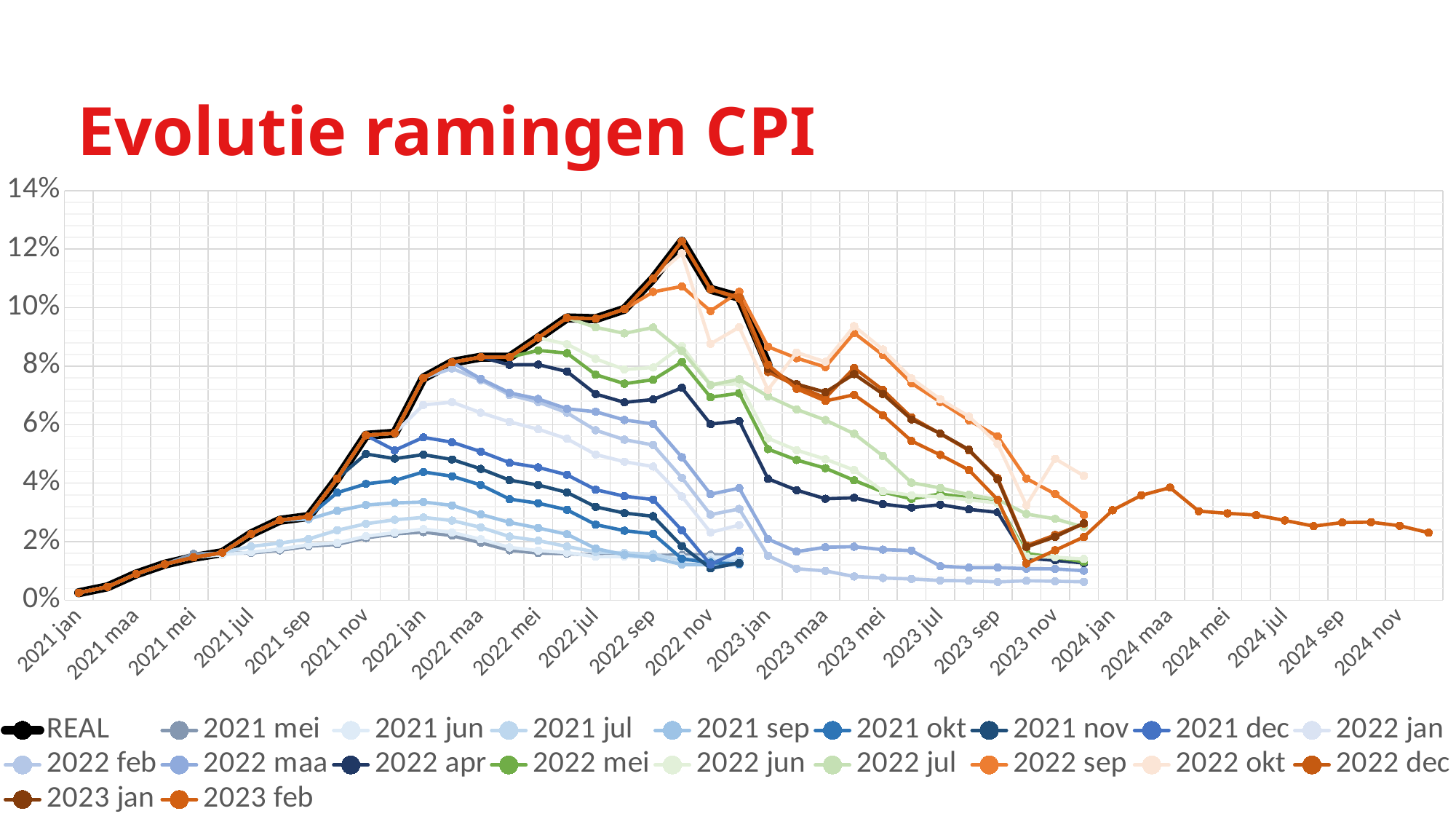
What is the title of the chart? Evolutie ramingen CPI What kind of chart is shown on the slide? line chart What is the highest value shown on the vertical axis? 14% Which series is drawn as the thick black line? REAL Is the peak value of the REAL series greater or less than 10%? greater Does the REAL series rise or fall between 2021 jan and 2022 okt? rise How many series does the legend list? 20 Which is larger for the REAL series: the value at 2022 okt or the value at 2021 jan? 2022 okt Is the value of the REAL series at 2021 jan greater or less than 2%? less Is the highest value of the 2021 mei series greater or less than 4%? less